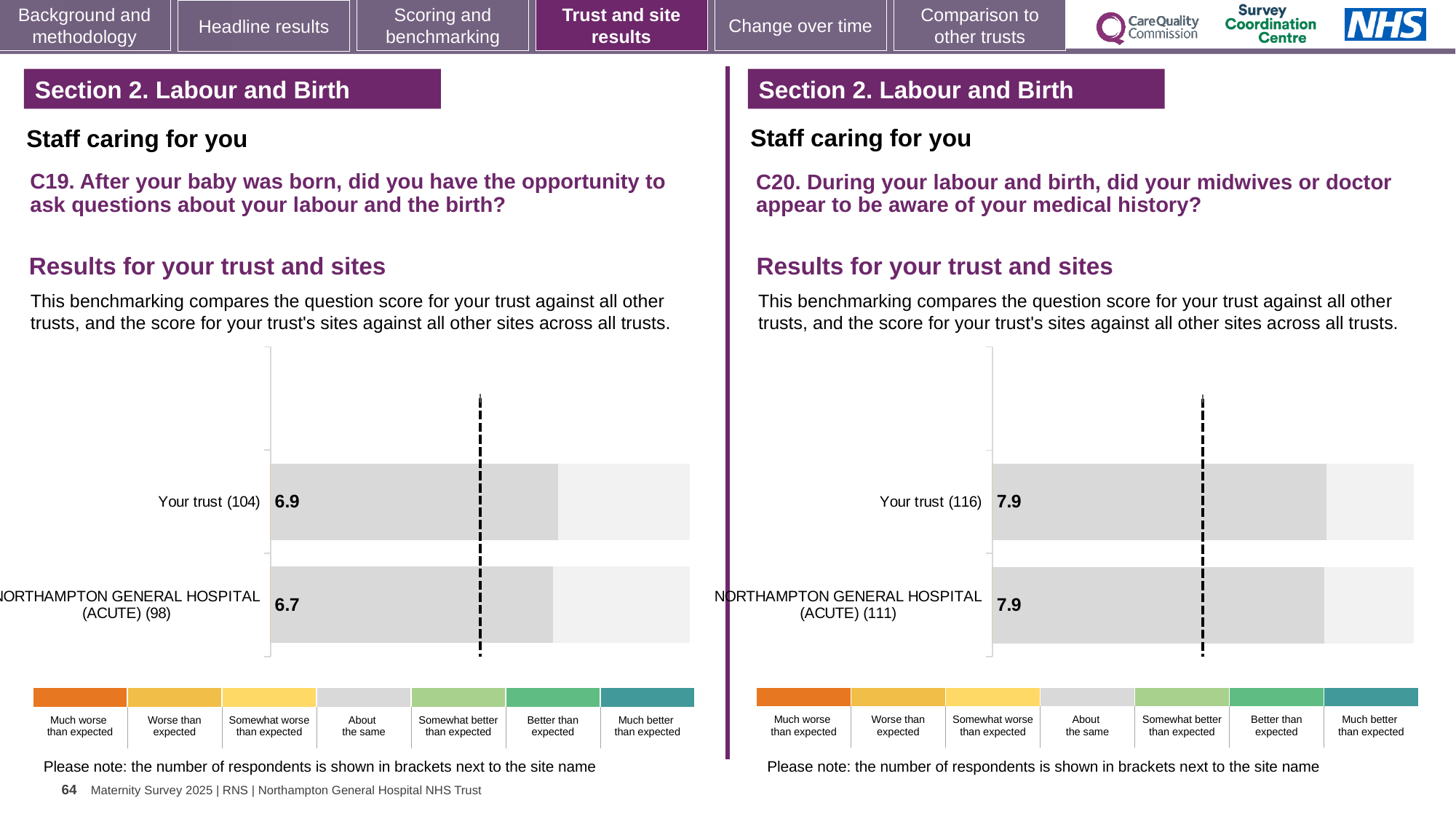
On the left chart (C19), how many respondents are shown in brackets for Your trust? 104 On the left chart (C19), what is the difference between the score for Your trust and the score for Northampton General Hospital (Acute)? 0.2 On the left chart (C19), which has the higher score, Your trust or Northampton General Hospital (Acute)? Your trust How many bars are plotted on the left chart (C19)? 2 On the left chart (C19), what is the score for Northampton General Hospital (Acute)? 6.7 On the right chart (C20), what is the score for Northampton General Hospital (Acute)? 7.9 On the right chart (C20), what is the score for Your trust? 7.9 How many bars are plotted on the right chart (C20)? 2 On the left chart (C19), what is the score for Your trust? 6.9 On the right chart (C20), how many respondents are shown in brackets for Northampton General Hospital (Acute)? 111 What type of chart is used on the left (C19)? Bar chart On the right chart (C20), what is the difference between the score for Your trust and the score for Northampton General Hospital (Acute)? 0